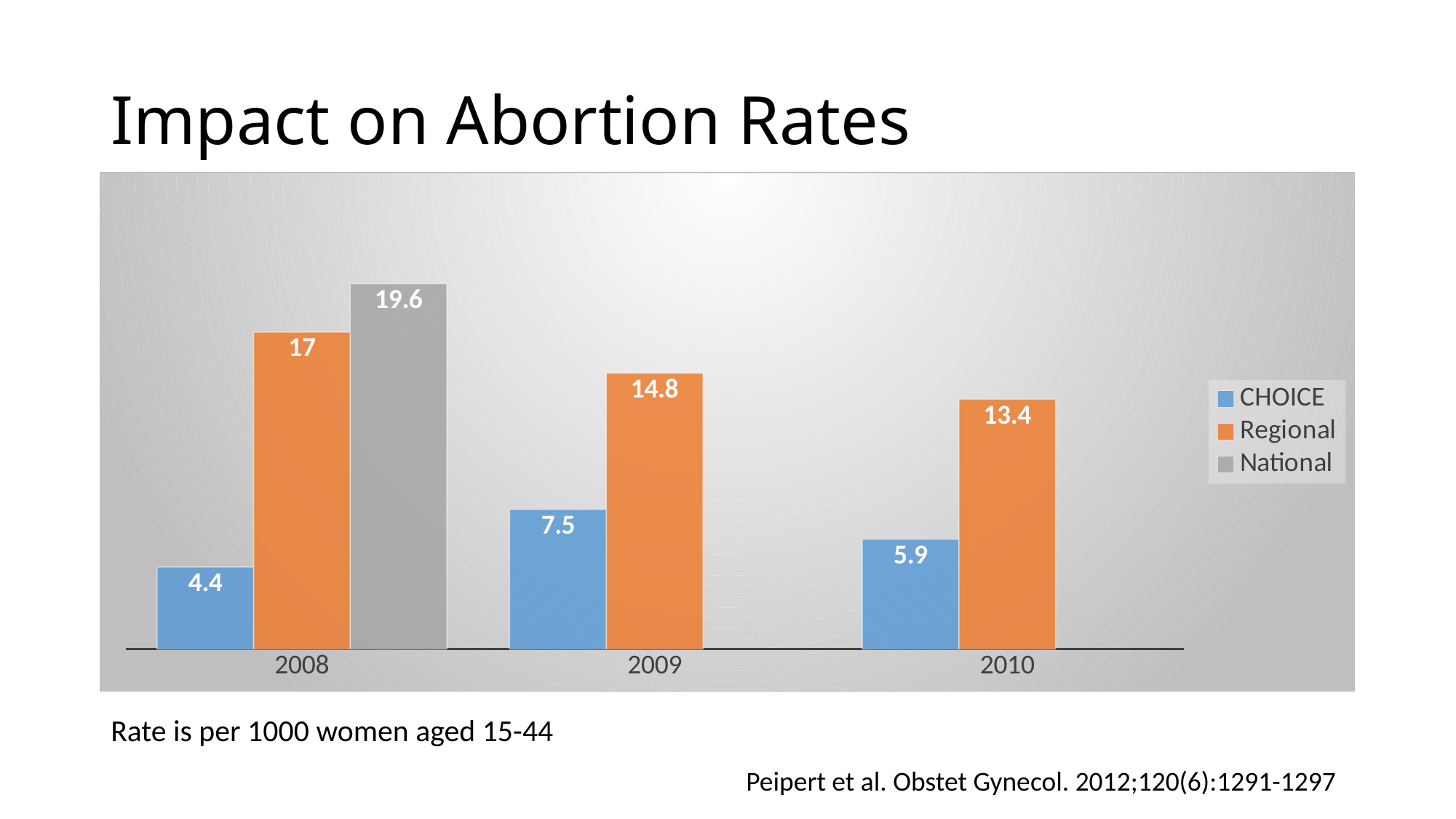
Which year has the highest CHOICE value? 2009 How many years are shown on the x axis? 3 What is the difference between the Regional values for 2009 and 2010? 1.4 What is the National value for 2008? 19.6 What is the Regional value for 2010? 13.4 Which is larger, the CHOICE value for 2009 or the CHOICE value for 2010? 2009 What is the difference between the Regional and CHOICE values in 2008? 12.6 What is the Regional value for 2009? 14.8 What kind of chart is shown on the slide? Bar chart How many series does the legend list? 3 What is the CHOICE value for 2008? 4.4 Which year has the lowest Regional value? 2010